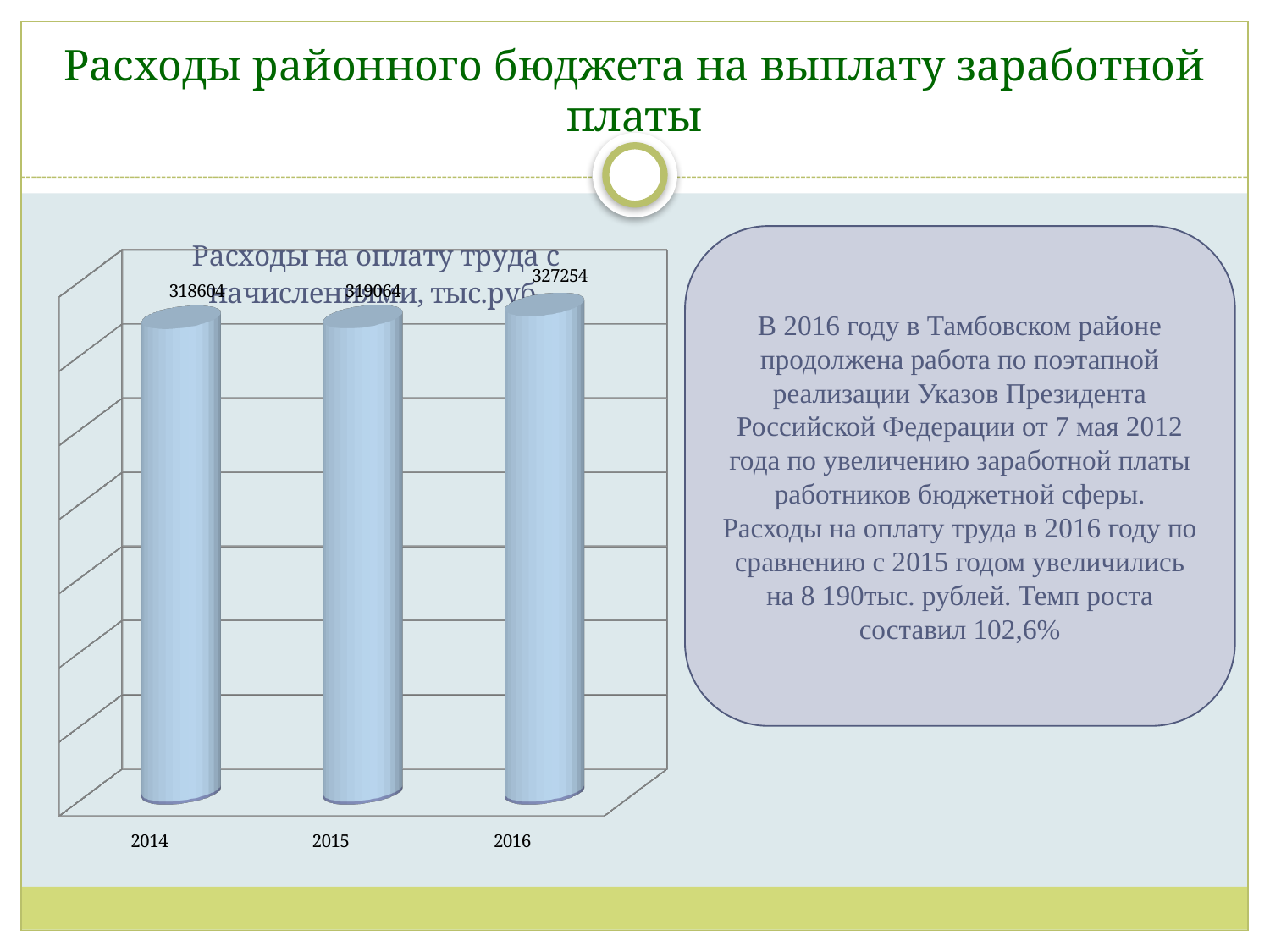
Which year has the lowest value in the chart? 2014 What is the title of the chart? Расходы на оплату труда с начислениями, тыс.руб What is the value for 2016 in the chart? 327254 What kind of chart is shown on the slide? bar chart How many years are shown on the x axis of the chart? 3 What is the difference between the values for 2016 and 2014? 8650 What is the value for 2015 in the chart? 319064 What is the value for 2014 in the chart? 318604 What is the difference between the values for 2016 and 2015? 8190 Do the values rise or fall from 2014 to 2016? rise Which is larger, the value for 2016 or the value for 2014? 2016 Which year has the highest value in the chart? 2016